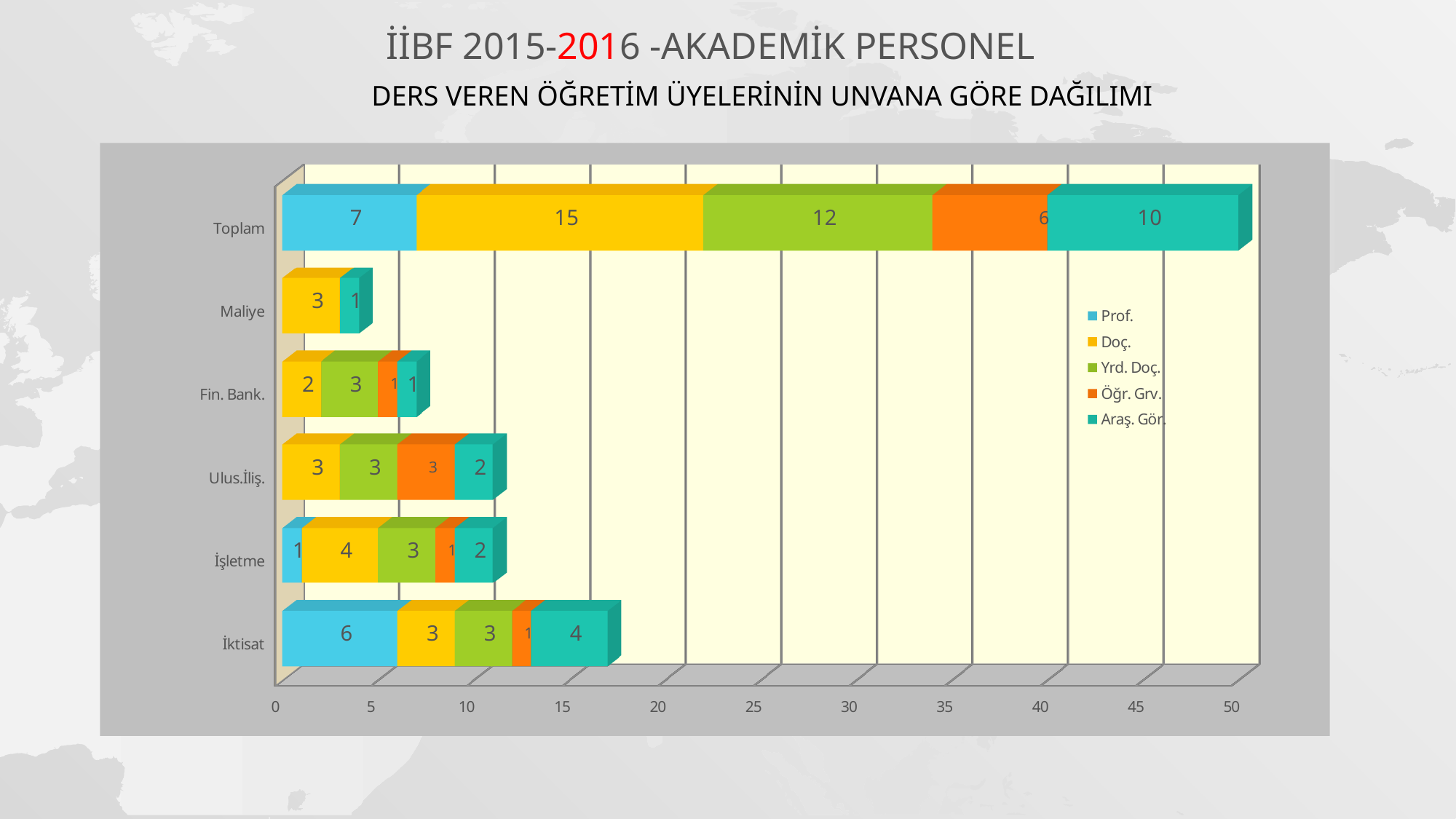
How many series does the legend list? 5 What is the total of the stacked bar for Toplam? 50 What is the Araş. Gör. value for Ulus.İliş.? 2 Which legend entry is shown in orange? Öğr. Grv. Which series has the highest value in the Toplam bar? Doç. What is the Prof. value for İktisat? 6 What type of chart is shown on the slide? Stacked bar chart How many categories are shown on the vertical axis? 6 Which is larger for İşletme: the Doç. value or the Araş. Gör. value? Doç. What is the difference between the Doç. value and the Prof. value for Toplam? 8 What is the Doç. value for Toplam? 15 What is the total of the stacked bar for İktisat? 17